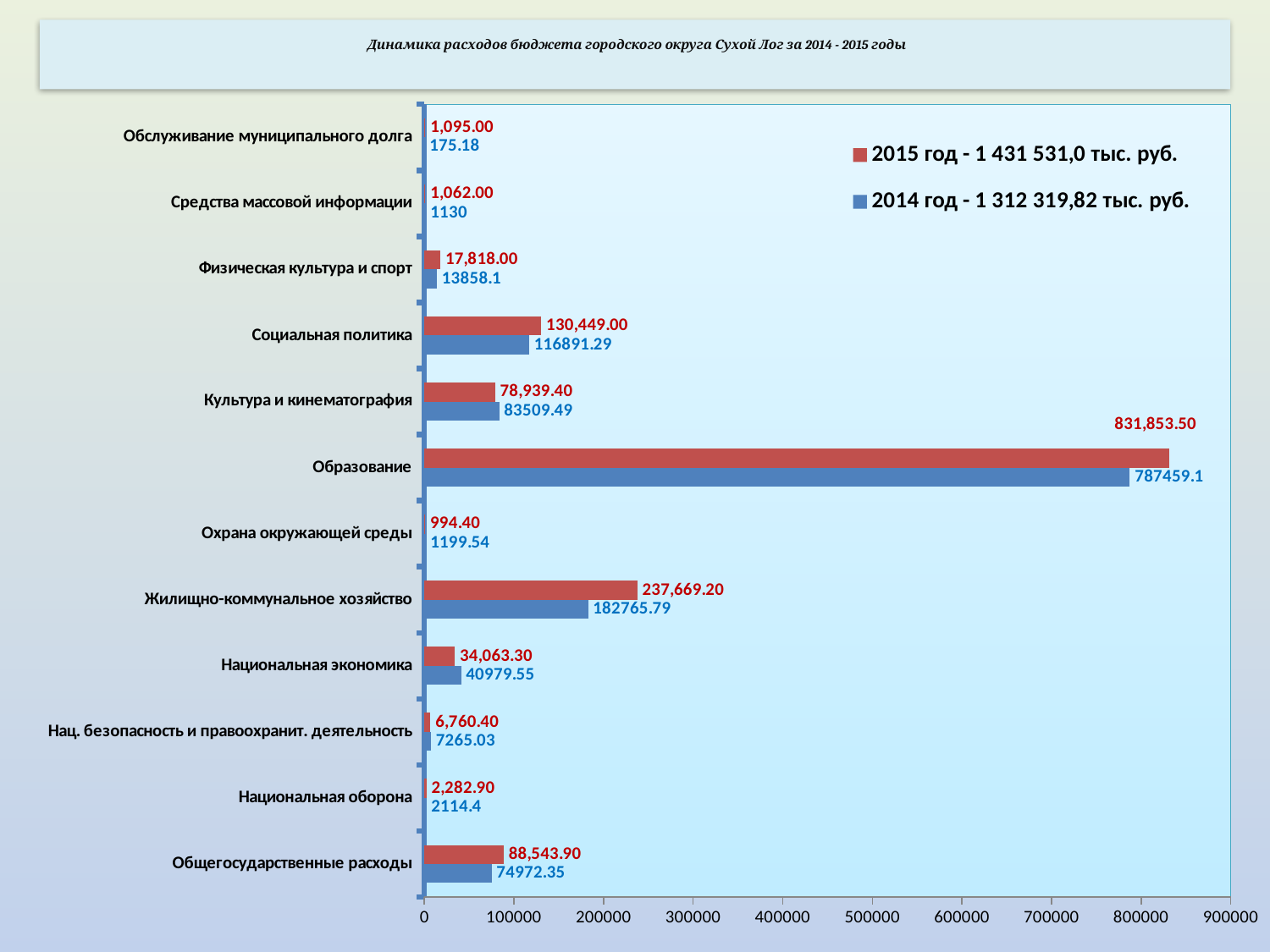
Which is larger for Национальная экономика: the 2015 value or the 2014 value? 2014 value What type of chart is shown on the slide? Bar chart By how much does the 2015 value for Образование exceed the 2014 value? 44,394.4 Which category has the lowest 2014 value? Обслуживание муниципального долга What is the 2015 value for Социальная политика? 130,449.00 How many series does the legend list? 2 What is the 2014 value for Жилищно-коммунальное хозяйство? 182765.79 According to the legend, what is the total for 2015 год? 1 431 531,0 тыс. руб. What is the 2014 value for Обслуживание муниципального долга? 175.18 How many expenditure categories are shown on the chart? 12 Which category has the highest 2015 value? Образование What is the 2015 value for Образование? 831,853.50